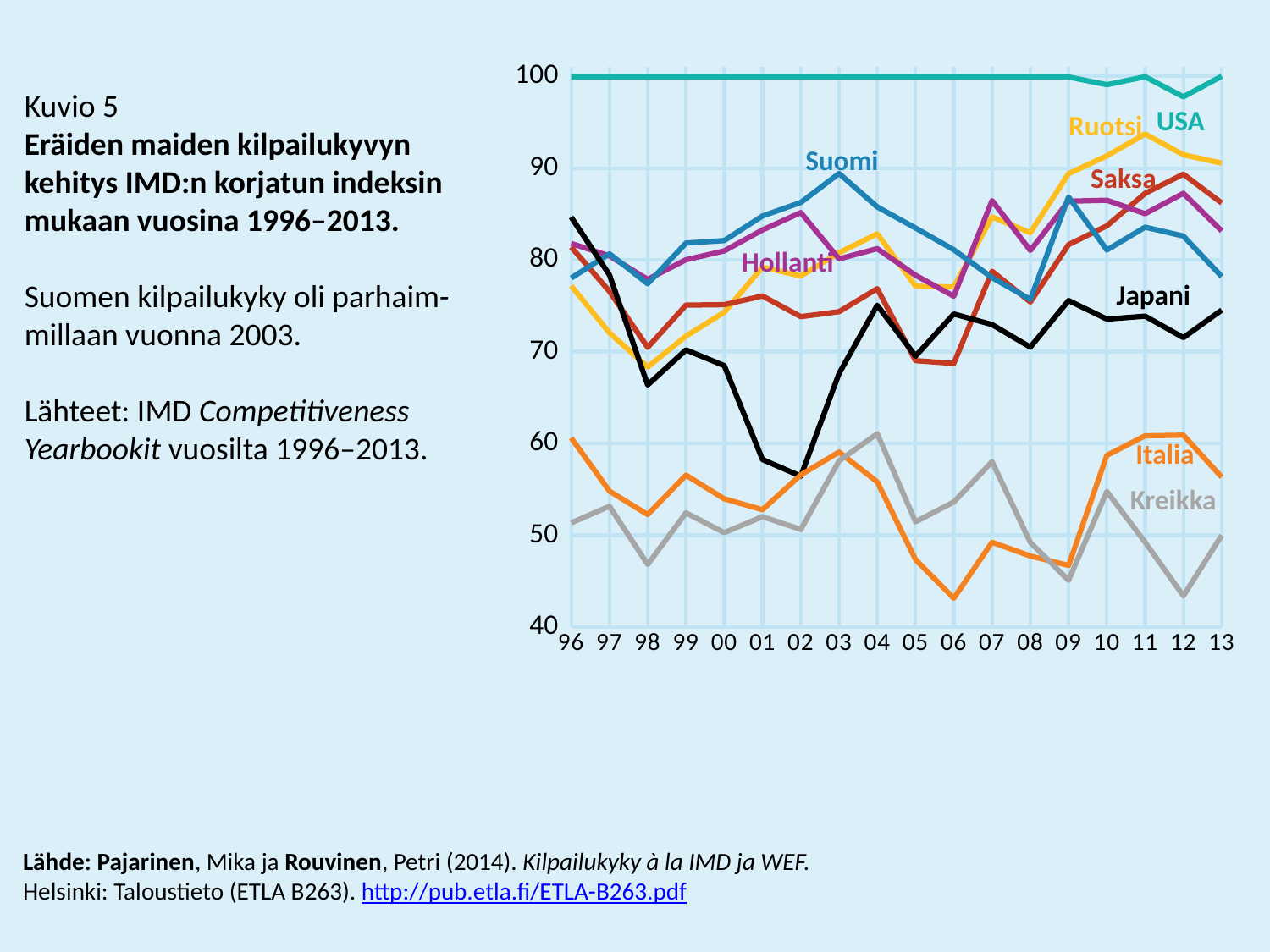
How many countries are plotted as lines in the chart? 8 Does the line for Japani rise or fall from 99 to 02? fall In 03, which is larger, the value for Suomi or the value for Japani? Suomi Which country has the lowest value in 06? Italia What is the highest value shown on the y axis of the chart? 100 How many years are plotted along the x axis of the chart? 18 What kind of chart is shown on the slide? line chart In 11, which is larger, the value for Ruotsi or the value for Saksa? Ruotsi Is the value for Japani in 02 greater or less than 60? less Is the value for Italia in 06 greater or less than 50? less Which country has the highest line across the whole period in the chart? USA Is the value for Suomi in 03 greater or less than 85? greater